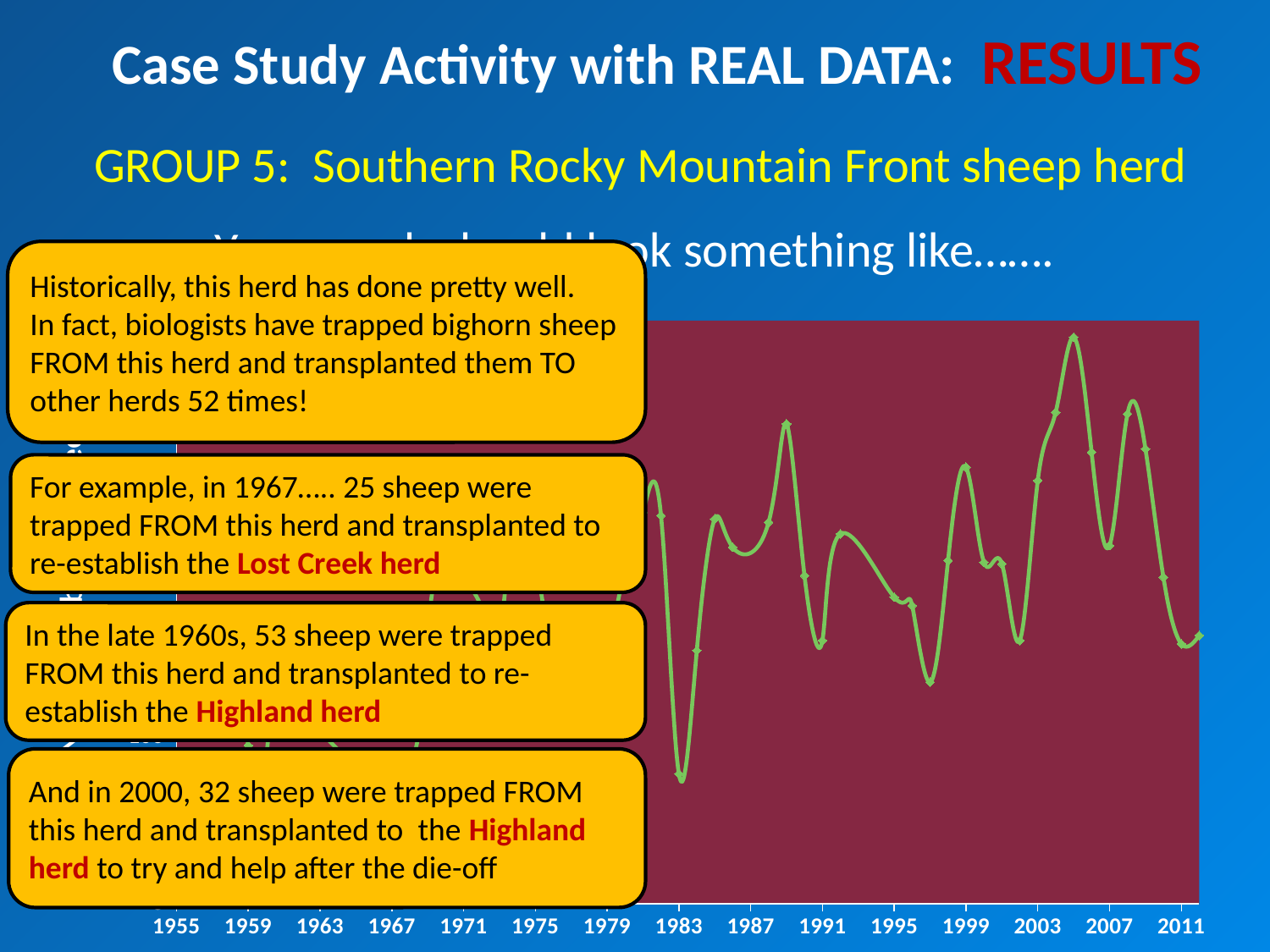
What kind of chart is shown on the slide? line chart Which year has the larger value on the line, 1983 or 1989? 1989 Among the years from 1983 onward, in which labelled year does the line reach its lowest point? 1983 Does the line rise or fall between 1983 and 1985? rise What is the first year labelled on the x axis of the chart? 1955 What is the last year labelled on the x axis of the chart? 2011 Does the line rise or fall between 2005 and 2007? fall How many year labels are shown along the x axis of the chart? 15 Which year has the larger value on the line, 2005 or 2011? 2005